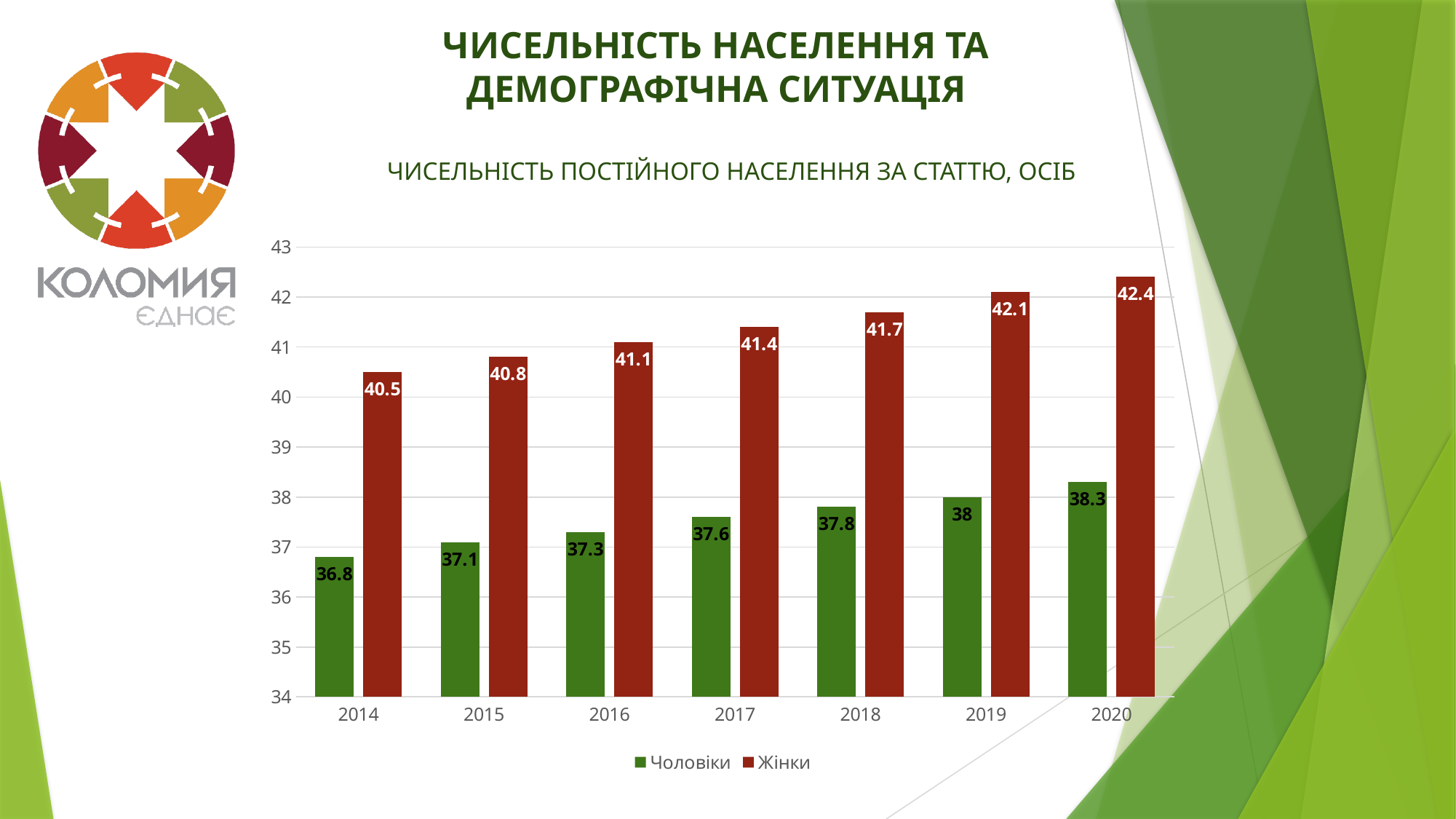
What is the value for Жінки in 2017? 41.4 What is the value for Чоловіки in 2019? 38 How many years are shown on the x axis? 7 How many series does the legend list? 2 What is the difference between Жінки and Чоловіки in 2018? 3.9 What kind of chart is shown on the slide? Bar chart In which year is the value for Чоловіки lowest? 2014 What is the value for Чоловіки in 2014? 36.8 Which is larger in 2016, the value for Чоловіки or for Жінки? Жінки What is the value for Жінки in 2020? 42.4 In which year is the value for Жінки highest? 2020 Do the values for Чоловіки rise or fall from 2014 to 2020? Rise